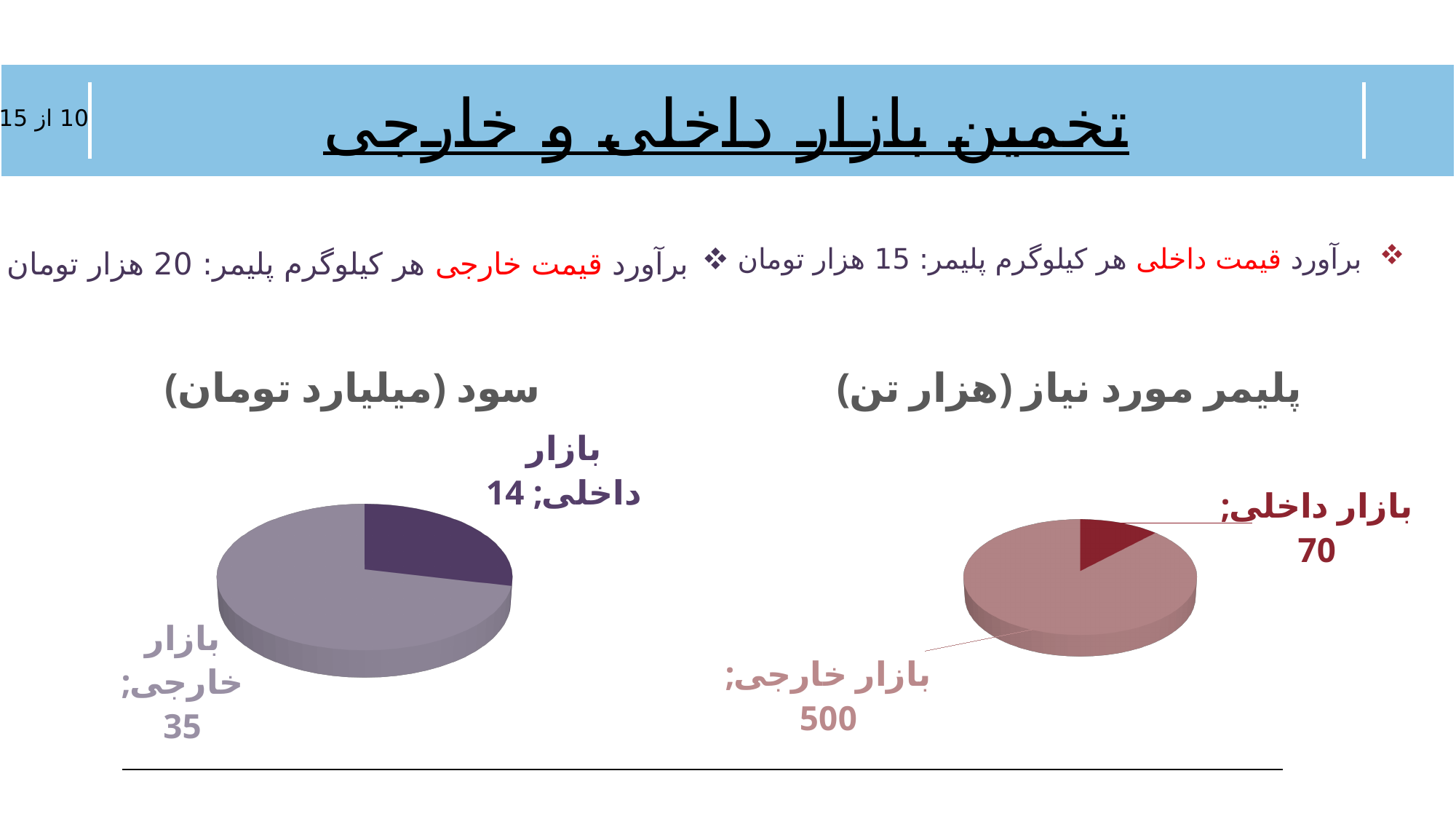
In the chart titled 'پلیمر مورد نیاز (هزار تن)', what is the value for بازار خارجی? 500 In the chart titled 'سود (میلیارد تومان)', what is the value for بازار خارجی? 35 In the chart titled 'پلیمر مورد نیاز (هزار تن)', what is the total of the two slices? 570 In the chart titled 'پلیمر مورد نیاز (هزار تن)', which category has the largest slice? بازار خارجی How many slices does the chart titled 'سود (میلیارد تومان)' have? 2 In the chart titled 'پلیمر مورد نیاز (هزار تن)', what is the difference between the values for بازار خارجی and بازار داخلی? 430 In the chart titled 'سود (میلیارد تومان)', which category has the smallest slice? بازار داخلی In the chart titled 'سود (میلیارد تومان)', what is the difference between the values for بازار خارجی and بازار داخلی? 21 In the chart titled 'سود (میلیارد تومان)', what is the value for بازار داخلی? 14 In the chart titled 'سود (میلیارد تومان)', which is larger: بازار داخلی or بازار خارجی? بازار خارجی In the chart titled 'پلیمر مورد نیاز (هزار تن)', what is the value for بازار داخلی? 70 What kind of chart is the chart titled 'پلیمر مورد نیاز (هزار تن)'? Pie chart